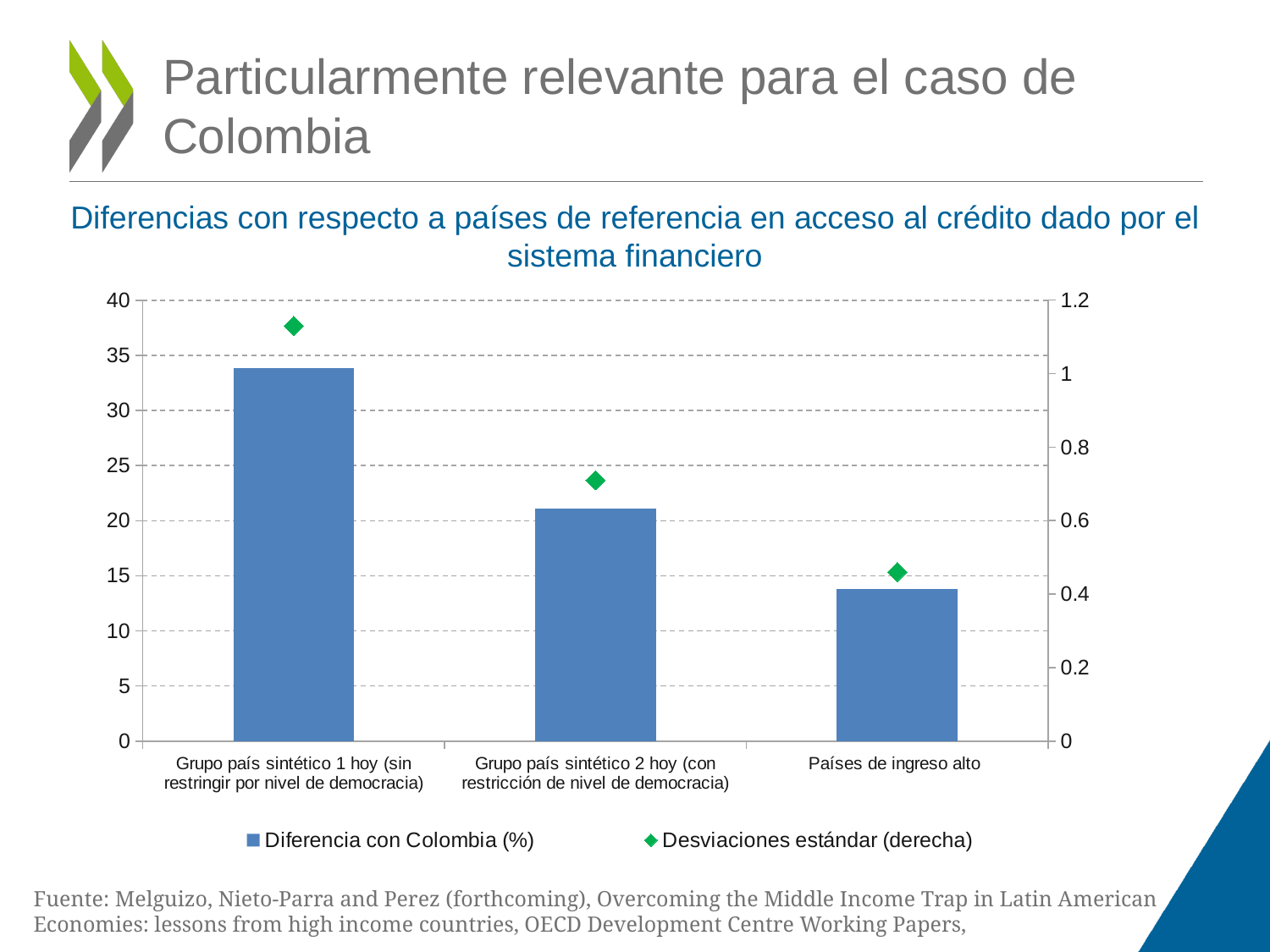
Is the 'Diferencia con Colombia (%)' value for 'Grupo país sintético 2 hoy (con restricción de nivel de democracia)' greater or less than 20? greater Is the 'Desviaciones estándar (derecha)' value for 'Grupo país sintético 1 hoy (sin restringir por nivel de democracia)' greater or less than 1? greater What kind of chart is shown on the slide? bar chart with a line/marker series (combination chart) Which category has the lowest value for 'Diferencia con Colombia (%)'? Países de ingreso alto Is the 'Diferencia con Colombia (%)' value for 'Grupo país sintético 1 hoy (sin restringir por nivel de democracia)' greater or less than 30? greater How many series does the chart legend list? 2 How many categories are shown on the x axis of the chart? 3 Which category has the highest value for 'Diferencia con Colombia (%)'? Grupo país sintético 1 hoy (sin restringir por nivel de democracia) Do the 'Diferencia con Colombia (%)' values rise or fall from left to right across the categories? fall Which is larger for 'Desviaciones estándar (derecha)': 'Grupo país sintético 2 hoy (con restricción de nivel de democracia)' or 'Países de ingreso alto'? Grupo país sintético 2 hoy (con restricción de nivel de democracia) What is the title of the chart? Diferencias con respecto a países de referencia en acceso al crédito dado por el sistema financiero